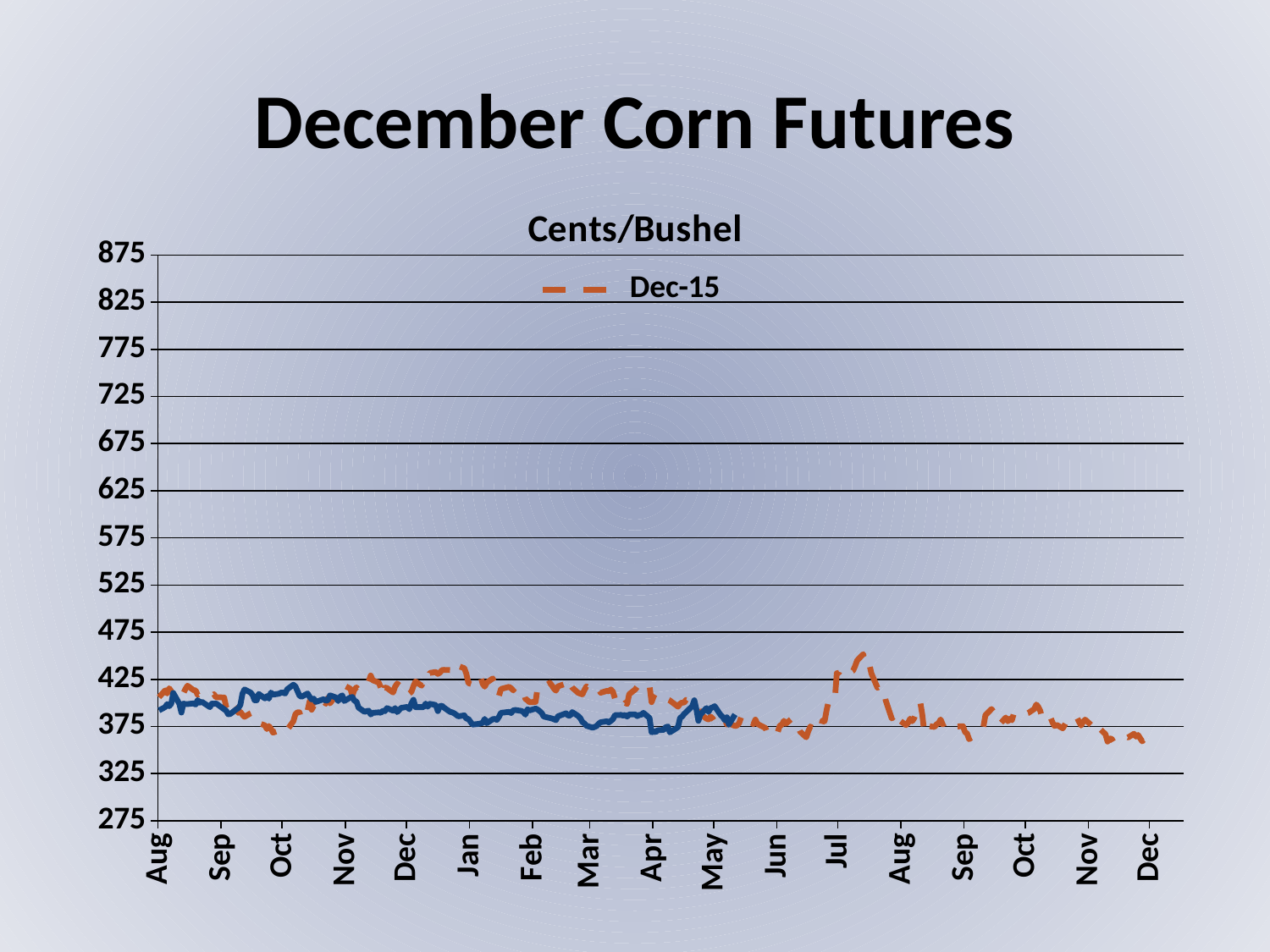
Is the peak value of the Dec-15 line in Jul greater or less than 425? greater Is the value of the Dec-15 line at the final Dec greater or less than 375? less What kind of chart is shown on the slide? Line chart What unit label is shown above the chart? Cents/Bushel In which month does the Dec-15 line reach its highest point? Jul How many month labels are shown along the x axis? 17 How many series does the legend list? 1 Is the value of the Dec-15 line around Jun greater or less than 400? less What is the title of the chart? Cents/Bushel Does the Dec-15 line rise or fall from Jul to the final Dec? fall